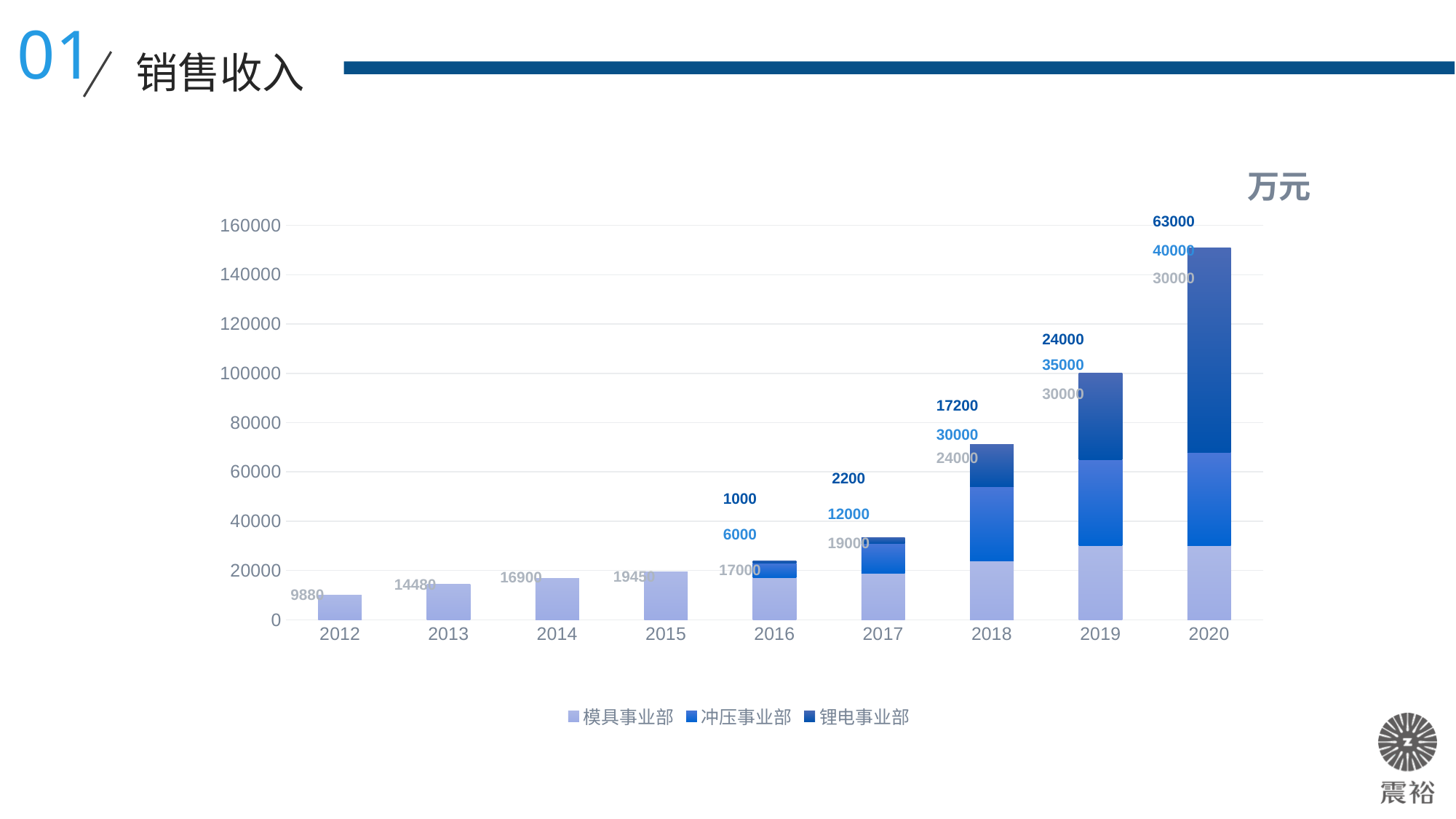
How many series does the legend list? 3 What is the value for 模具事业部 in 2015? 19450 What is the difference between the 冲压事业部 values for 2019 and 2018? 5000 Which year has the highest total sales revenue? 2020 What type of chart is shown on the slide? stacked bar chart What is the value for 锂电事业部 in 2020? 63000 How many years are shown on the x axis? 9 What unit is shown at the top right of the chart? 万元 Which year has the lowest total sales revenue? 2012 What is the value for 冲压事业部 in 2017? 12000 What is the total of the stacked bar for 2018? 71200 What is the value for 模具事业部 in 2012? 9880